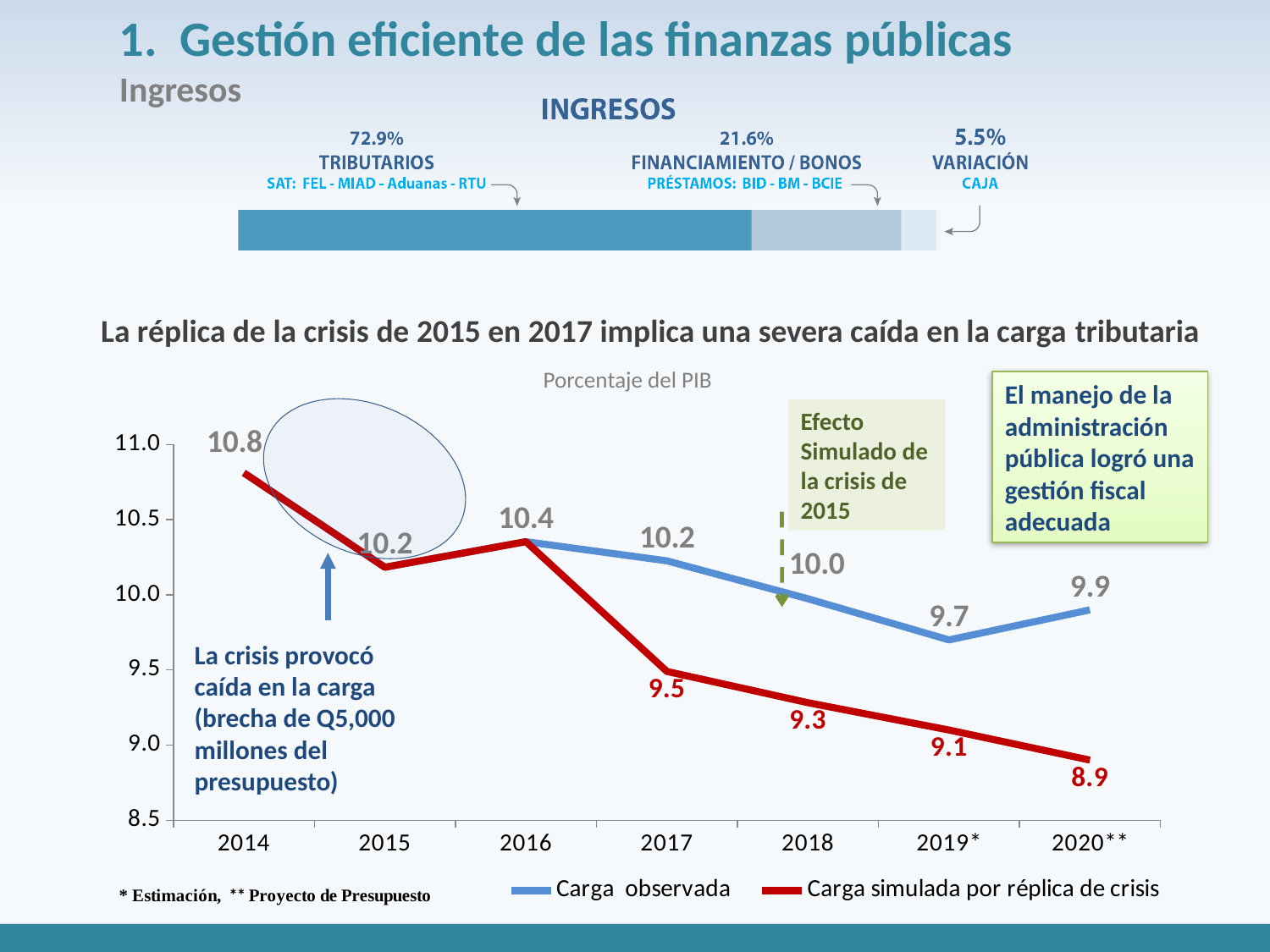
In the line chart 'Porcentaje del PIB', what is the value of 'Carga observada' in 2014? 10.8 In the line chart 'Porcentaje del PIB', how many series does the legend list? 2 In the 'INGRESOS' bar at the top of the slide, what percentage corresponds to 'TRIBUTARIOS'? 72.9% In the line chart 'Porcentaje del PIB', what is the difference between 'Carga observada' and 'Carga simulada por réplica de crisis' in 2020**? 1.0 In the line chart 'Porcentaje del PIB', in which year is 'Carga observada' highest? 2014 In the line chart 'Porcentaje del PIB', which series has the larger value in 2018, 'Carga observada' or 'Carga simulada por réplica de crisis'? Carga observada In the line chart 'Porcentaje del PIB', what is the value of 'Carga observada' in 2019*? 9.7 In the line chart 'Porcentaje del PIB', how many years are shown on the x axis? 7 In the line chart 'Porcentaje del PIB', in which year is 'Carga observada' lowest? 2019* In the line chart 'Porcentaje del PIB', what is the value of 'Carga simulada por réplica de crisis' in 2020**? 8.9 In the line chart 'Porcentaje del PIB', what is the value of 'Carga simulada por réplica de crisis' in 2017? 9.5 In the line chart 'Porcentaje del PIB', does 'Carga simulada por réplica de crisis' rise or fall from 2017 to 2020**? fall